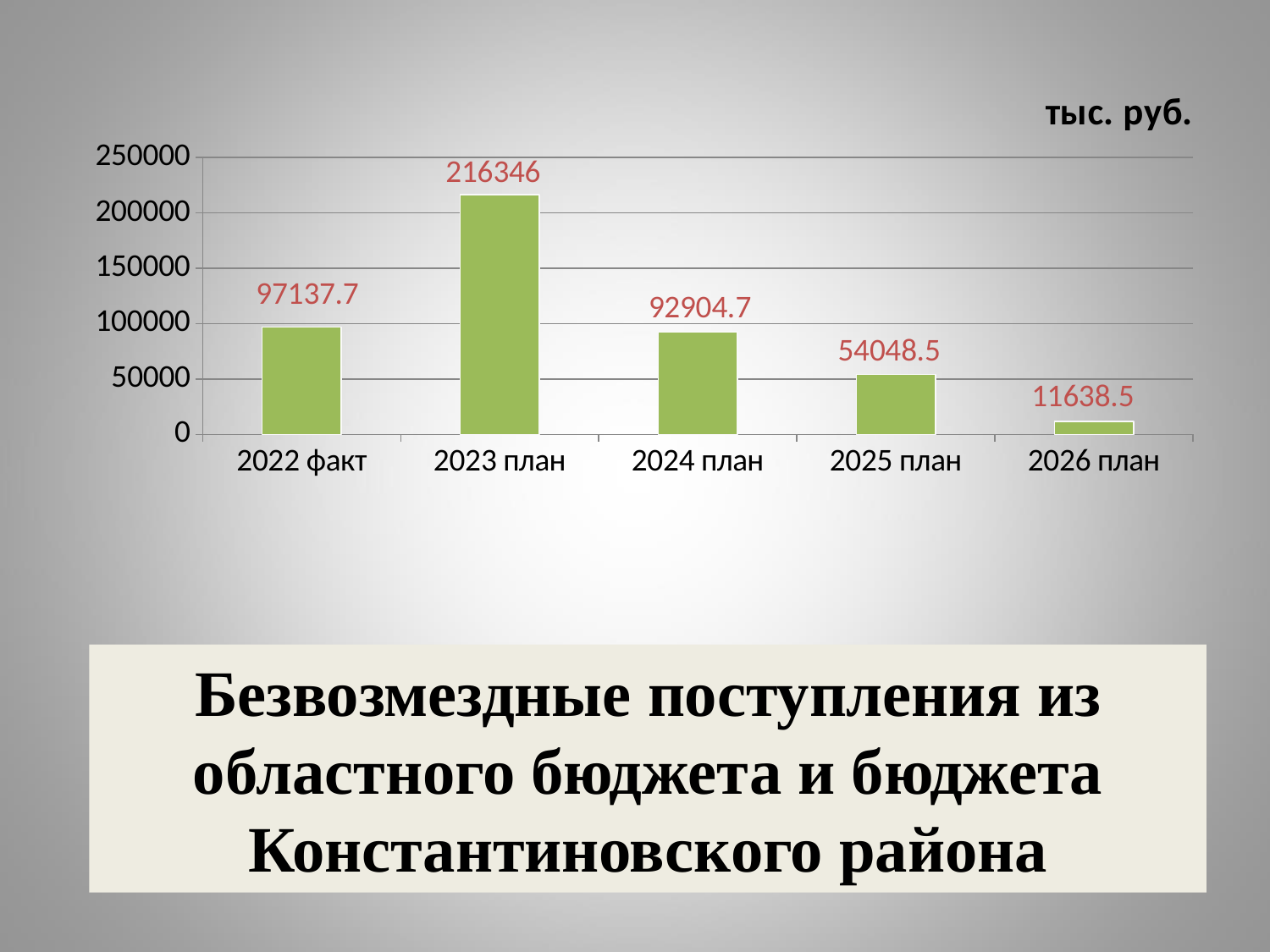
Which is larger, the value for 2022 факт or the value for 2024 план? 2022 факт What kind of chart is shown on the slide? bar chart Which category has the highest value? 2023 план How many categories are shown on the x axis? 5 Which category has the lowest value? 2026 план What is the value for 2022 факт? 97137.7 Is the value for 2025 план greater or less than 100000? less Do the values rise or fall from 2023 план to 2026 план? fall What is the value for 2023 план? 216346 What is the value for 2025 план? 54048.5 What is the value for 2026 план? 11638.5 What is the difference between the values for 2023 план and 2024 план? 123441.3